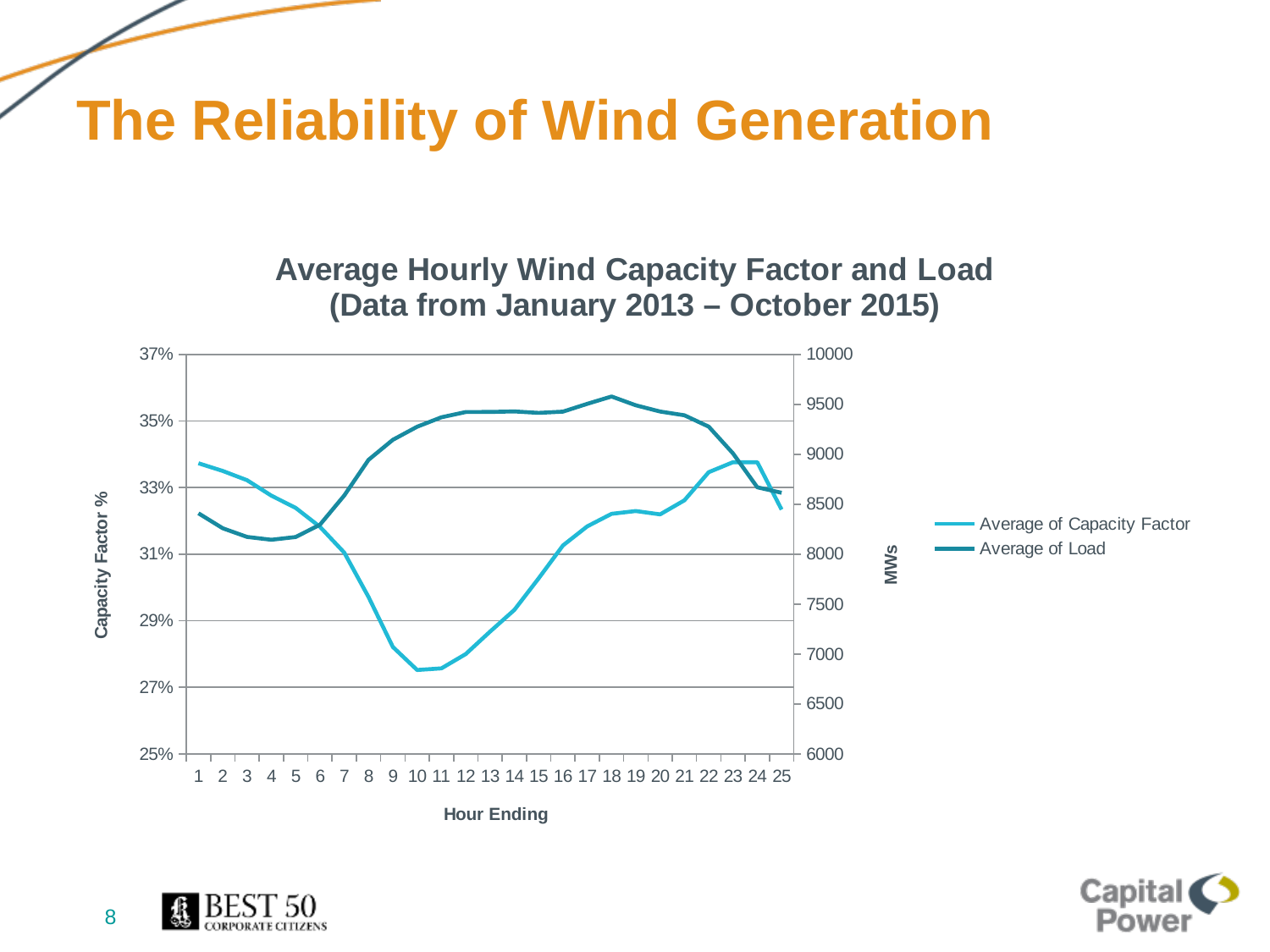
What is the title of the chart? Average Hourly Wind Capacity Factor and Load (Data from January 2013 – October 2015) What is the label of the right-hand vertical axis? MWs At which hour ending does the Average of Load reach its highest value? 18 What kind of chart is shown on the slide? Line chart Is the Average of Load at hour ending 12 greater or less than 9000? greater How many series does the legend list? 2 Is the Average of Capacity Factor at hour ending 1 greater or less than 33%? greater How many hour-ending points are plotted along the x axis? 25 Is the Average of Capacity Factor at hour ending 10 greater or less than 29%? less Which is larger, the Average of Load at hour ending 10 or at hour ending 4? Hour ending 10 Does the Average of Capacity Factor rise or fall from hour ending 1 to hour ending 10? fall